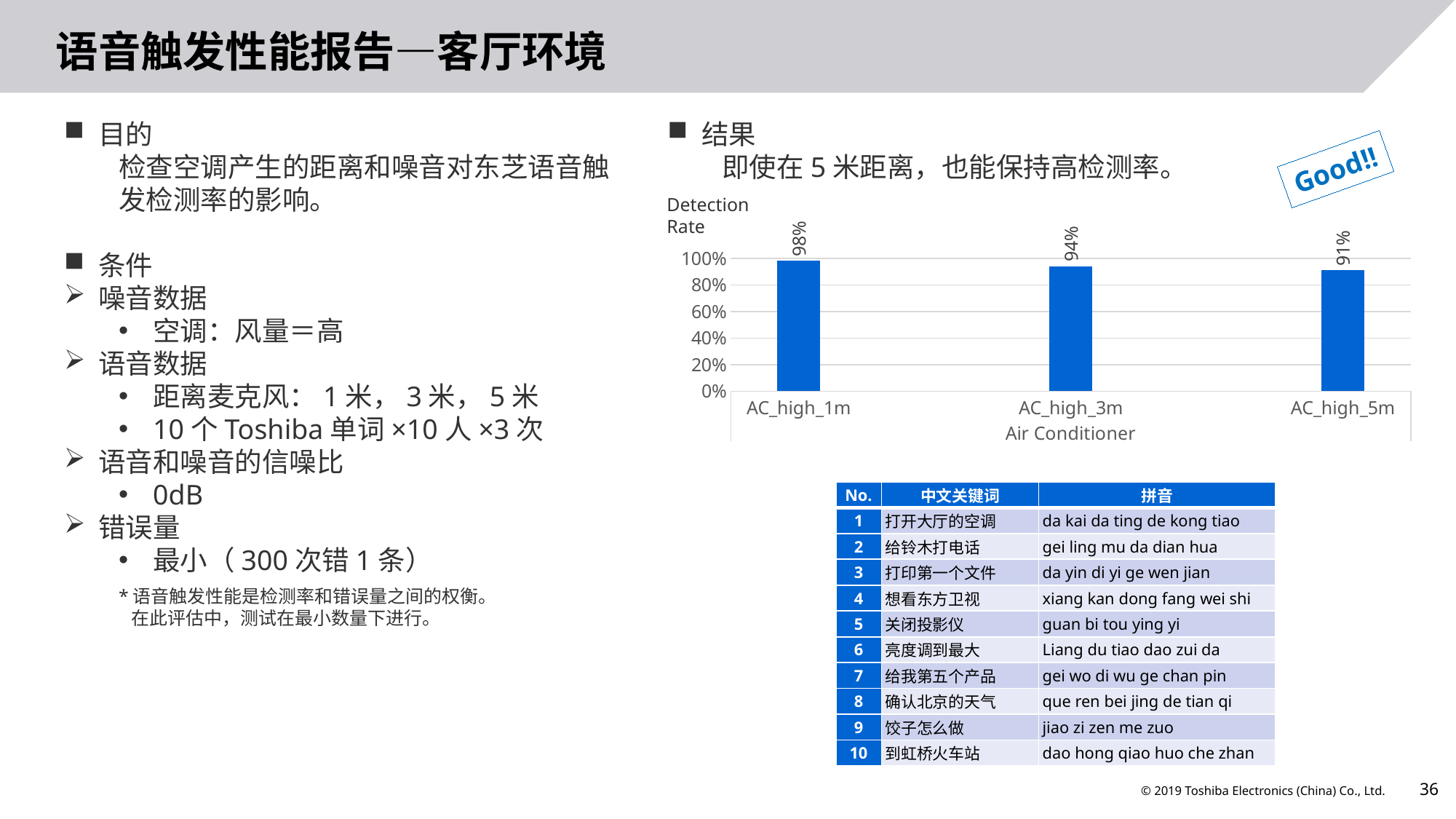
What is the difference in detection rate between AC_high_3m and AC_high_5m? 3% Which category has the lowest detection rate? AC_high_5m What is the detection rate for AC_high_1m? 98% Do the detection rates rise or fall as the distance increases from AC_high_1m to AC_high_5m? fall What is the detection rate for AC_high_5m? 91% Which has a higher detection rate, AC_high_1m or AC_high_3m? AC_high_1m Is the detection rate for AC_high_5m greater or less than 80%? greater Which category has the highest detection rate? AC_high_1m What kind of chart is shown on the slide? bar chart What is the difference in detection rate between AC_high_1m and AC_high_5m? 7% How many categories are shown on the chart? 3 What is the detection rate for AC_high_3m? 94%